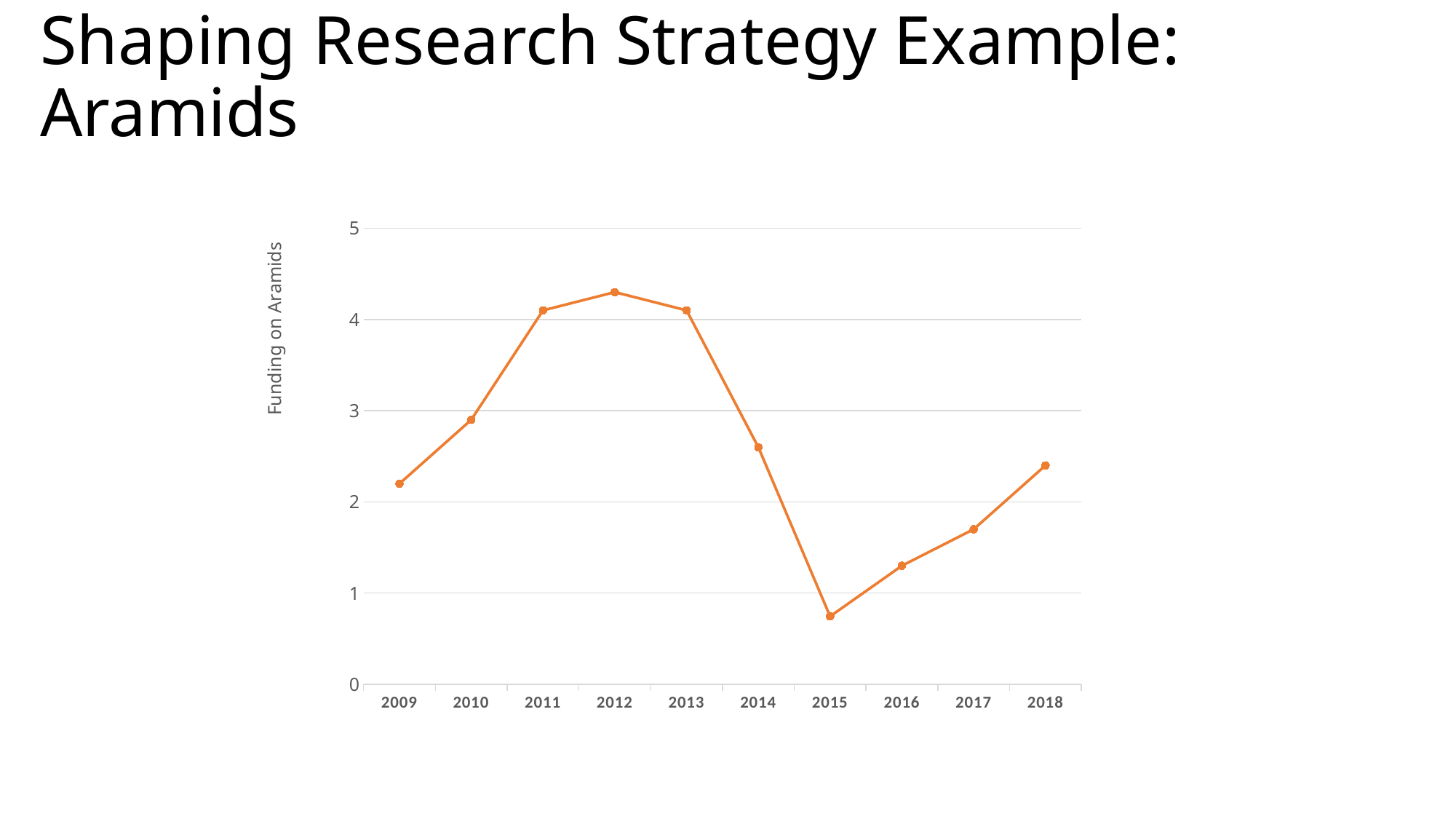
What is the label on the y axis? Funding on Aramids Which year has the highest funding on Aramids? 2012 What kind of chart is shown on the slide? line chart Is the value for 2012 greater or less than 4? greater Do the values rise or fall from 2012 to 2015? fall Is the value for 2017 greater or less than 2? less Is the value for 2009 greater or less than 2? greater Which is larger, the value for 2011 or the value for 2014? 2011 Which is larger, the value for 2016 or the value for 2017? 2017 Which year has the lowest funding on Aramids? 2015 How many years are plotted on the x axis? 10